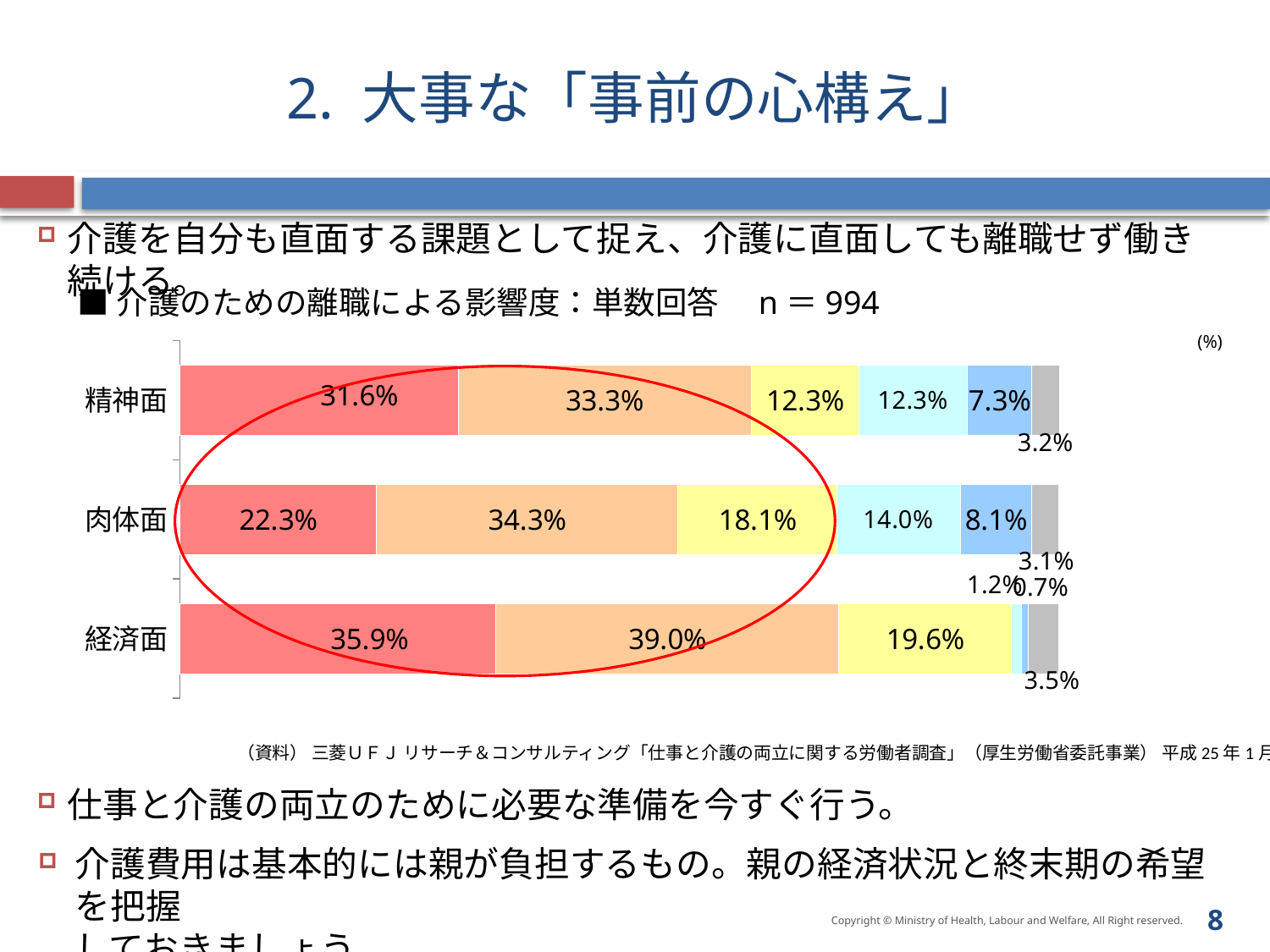
What is the value of the first (red) segment for 精神面? 31.6% Which is larger: the yellow segment for 精神面 or the yellow segment for 肉体面? 肉体面 What is the title of the chart? 介護のための離職による影響度：単数回答 What is the value of the second (orange) segment for 経済面? 39.0% What is the value of the yellow segment for 肉体面? 18.1% What is the sample size (n) stated above the chart? 994 Which category has the smallest first (red) segment? 肉体面 What is the value of the last (gray) segment for 経済面? 3.5% What is the difference between the second (orange) segment of 経済面 and that of 精神面? 5.7 percentage points Which category has the largest first (red) segment? 経済面 What kind of chart is shown on the slide? Stacked bar chart How many categories are plotted on the vertical axis of the chart? 3